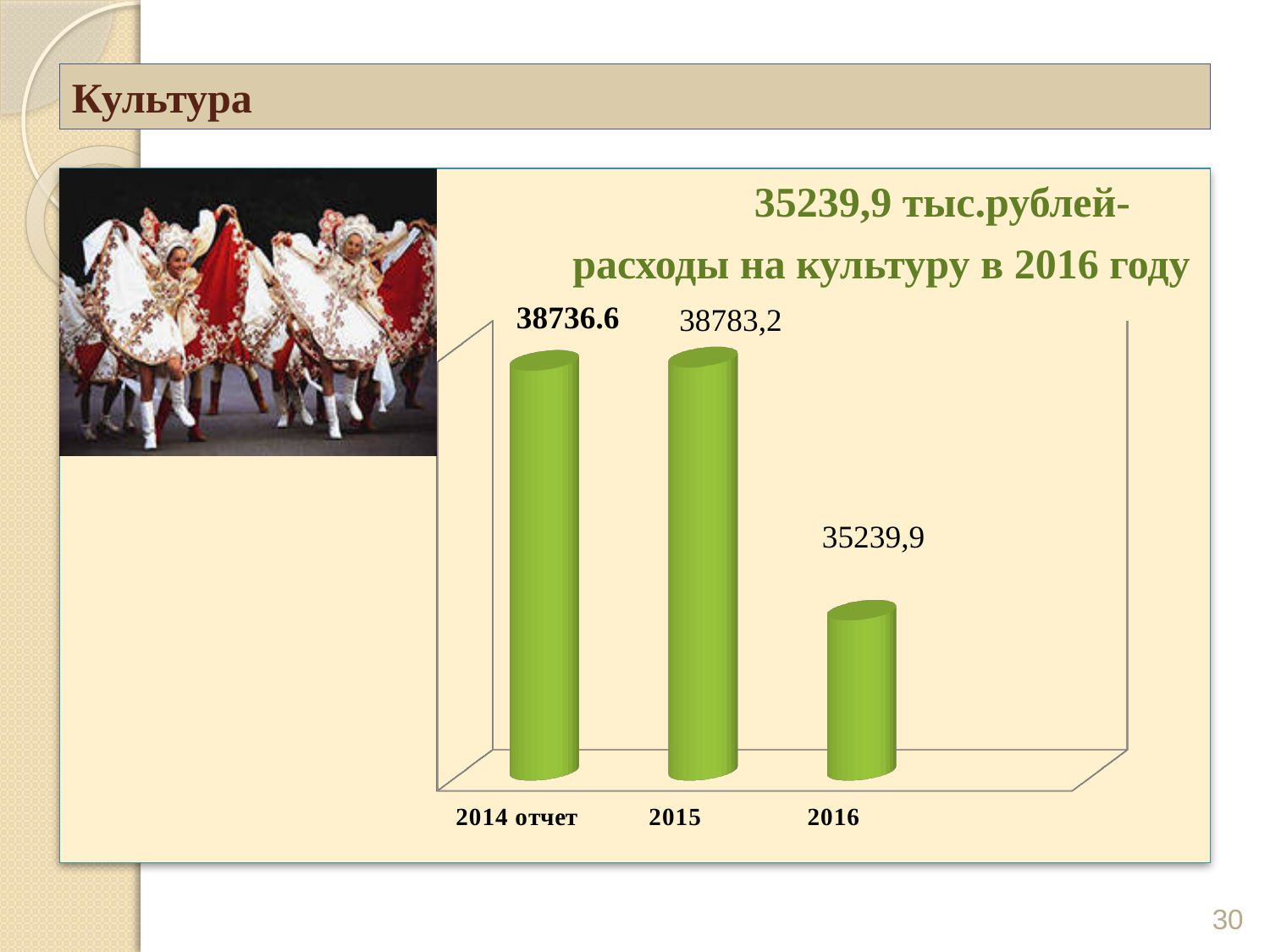
Does the value rise or fall from 2015 to 2016? Fall What kind of chart is shown on the slide? Bar chart What is the difference between the values for 2015 and 2016? 3543,3 What is the value for 2015? 38783,2 How many categories are shown on the x axis? 3 What is the difference between the values for 2014 отчет and 2016? 3496,7 What is the value for 2014 отчет? 38736.6 Which is larger, the value for 2015 or the value for 2016? 2015 Which year has the lowest value? 2016 What colour are the bars in the chart? Green Which is larger, the value for 2014 отчет or the value for 2016? 2014 отчет What is the value for 2016? 35239,9